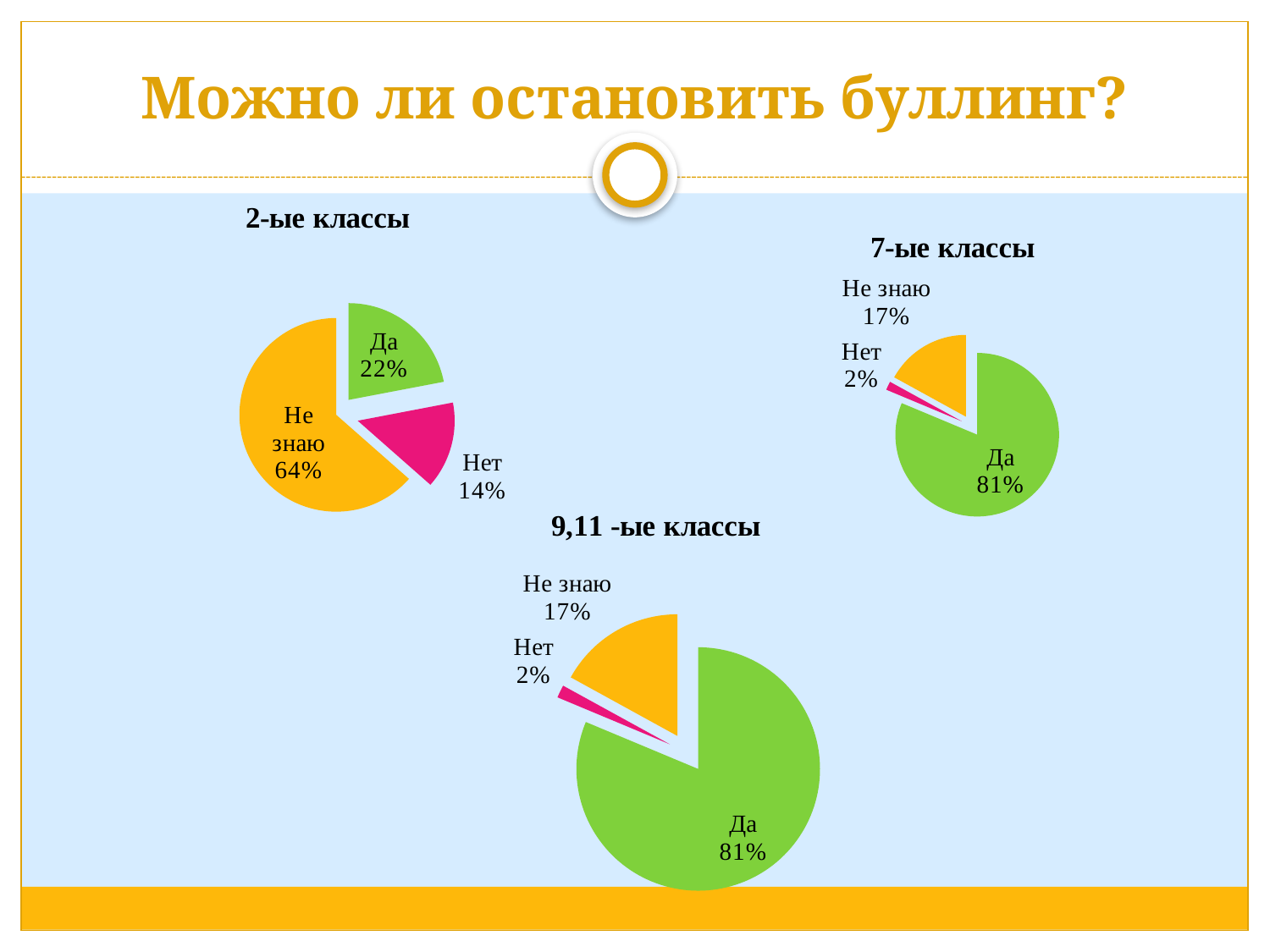
In the '2-ые классы' chart, what share of respondents answered 'Да'? 22% In the '9,11 -ые классы' chart, which answer has the largest share? Да In the '2-ые классы' chart, which is larger: the share for 'Да' or the share for 'Нет'? Да In the '2-ые классы' chart, what share of respondents answered 'Нет'? 14% In the '9,11 -ые классы' chart, what share of respondents answered 'Не знаю'? 17% In the '2-ые классы' chart, what share of respondents answered 'Не знаю'? 64% In the '2-ые классы' chart, which answer has the largest share? Не знаю In the '7-ые классы' chart, what share of respondents answered 'Нет'? 2% In the '2-ые классы' chart, what is the difference between the 'Не знаю' share and the 'Да' share? 42% In the '7-ые классы' chart, which answer has the smallest share? Нет What kind of chart is used for the '7-ые классы' data? Pie chart In the '7-ые классы' chart, what share of respondents answered 'Да'? 81%